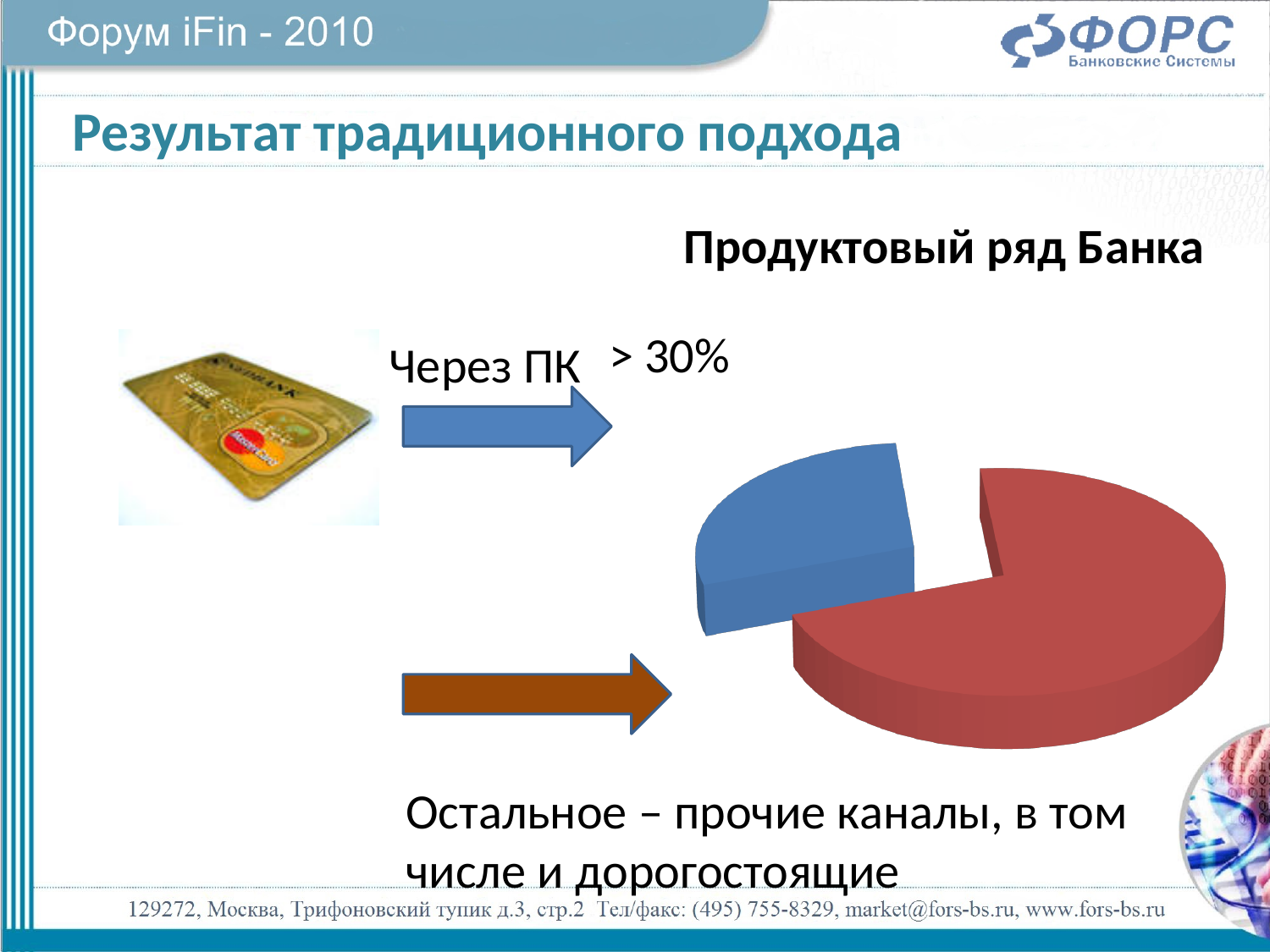
Is the share of the red slice (Остальное – прочие каналы) greater or less than 50%? greater Which category takes the smallest share of the pie chart? Через ПК Is the share of the blue slice (Через ПК) greater or less than 50%? less What kind of chart is shown on the slide? pie chart Which slice of the pie chart is larger, the blue one (Через ПК) or the red one (Остальное – прочие каналы)? the red one (Остальное – прочие каналы) What is the title of the chart on the slide? Продуктовый ряд Банка What colour is the slice labelled Через ПК in the pie chart? blue How many slices does the pie chart have? 2 Which category takes the largest share of the pie chart? Остальное – прочие каналы